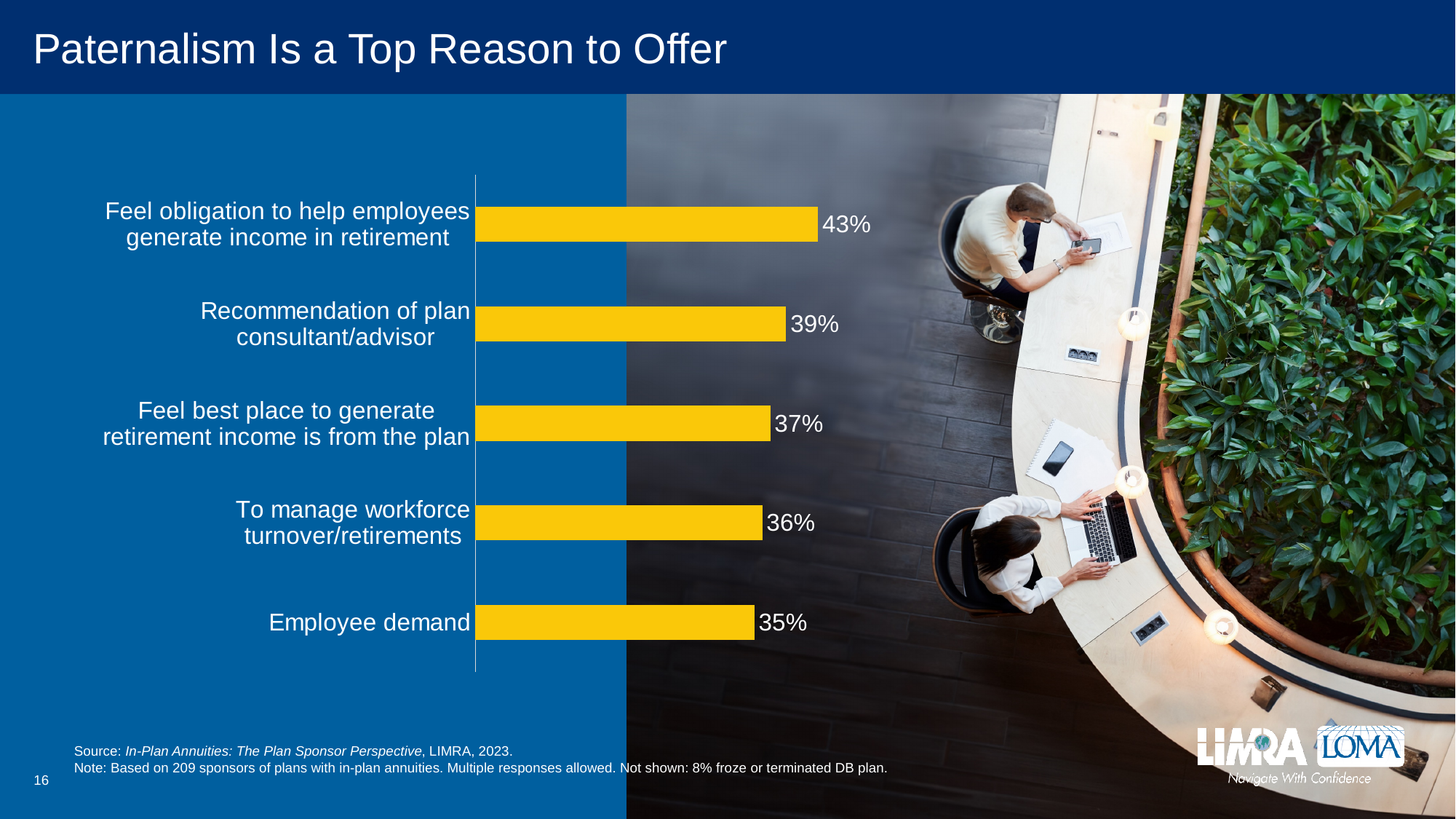
How many reasons are shown in the chart? 5 What kind of chart is shown on the slide? Bar chart What is the difference between 'Feel best place to generate retirement income is from the plan' and 'To manage workforce turnover/retirements'? 1 percentage point Which reason has the lowest percentage? Employee demand What is the difference in percentage points between 'Feel obligation to help employees generate income in retirement' and 'Employee demand'? 8 percentage points What is the value for 'Recommendation of plan consultant/advisor'? 39% What is the value for 'Employee demand'? 35% What is the value for 'To manage workforce turnover/retirements'? 36% What percentage of sponsors cited 'Feel obligation to help employees generate income in retirement' as a reason to offer? 43% Which reason has the highest percentage? Feel obligation to help employees generate income in retirement What colour are the bars in the chart? Yellow Which is larger: the value for 'Recommendation of plan consultant/advisor' or the value for 'Feel best place to generate retirement income is from the plan'? Recommendation of plan consultant/advisor